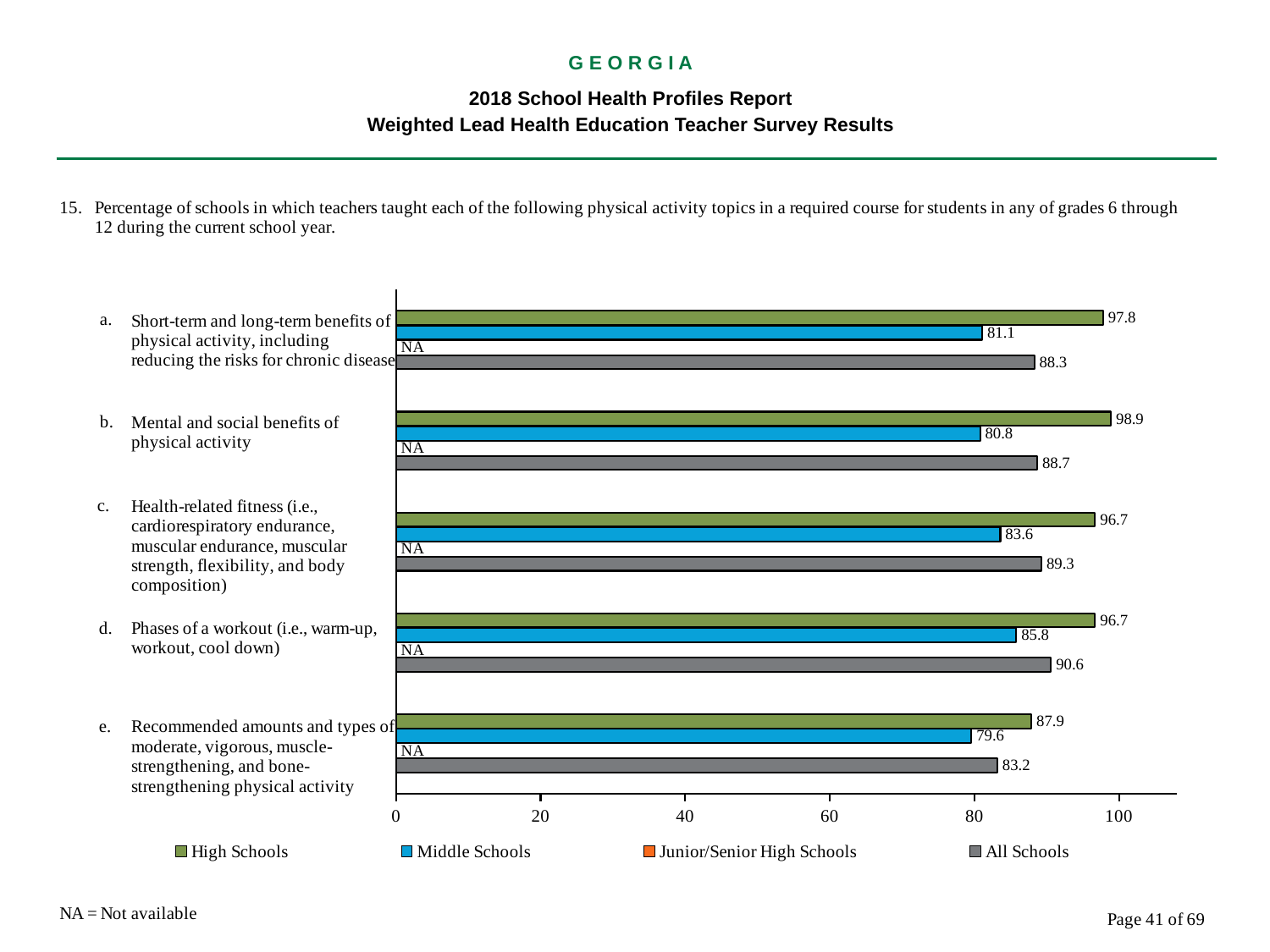
Which topic has the highest High Schools value? Mental and social benefits of physical activity What is the difference between the High Schools and Middle Schools values for 'Short-term and long-term benefits of physical activity, including reducing the risks for chronic disease'? 16.7 What is the High Schools value for 'Mental and social benefits of physical activity'? 98.9 How many series does the legend list? 4 What is the Middle Schools value for 'Phases of a workout (i.e., warm-up, workout, cool down)'? 85.8 How many physical activity topics are listed on the chart? 5 Which is larger for 'Phases of a workout': the All Schools value or the Middle Schools value? All Schools Which topic has the lowest Middle Schools value? Recommended amounts and types of moderate, vigorous, muscle-strengthening, and bone-strengthening physical activity What is the All Schools value for 'Recommended amounts and types of moderate, vigorous, muscle-strengthening, and bone-strengthening physical activity'? 83.2 What kind of chart is shown on the slide? bar chart Is the Middle Schools value for 'Mental and social benefits of physical activity' greater or less than 100? less What value is shown for Junior/Senior High Schools for 'Health-related fitness'? NA